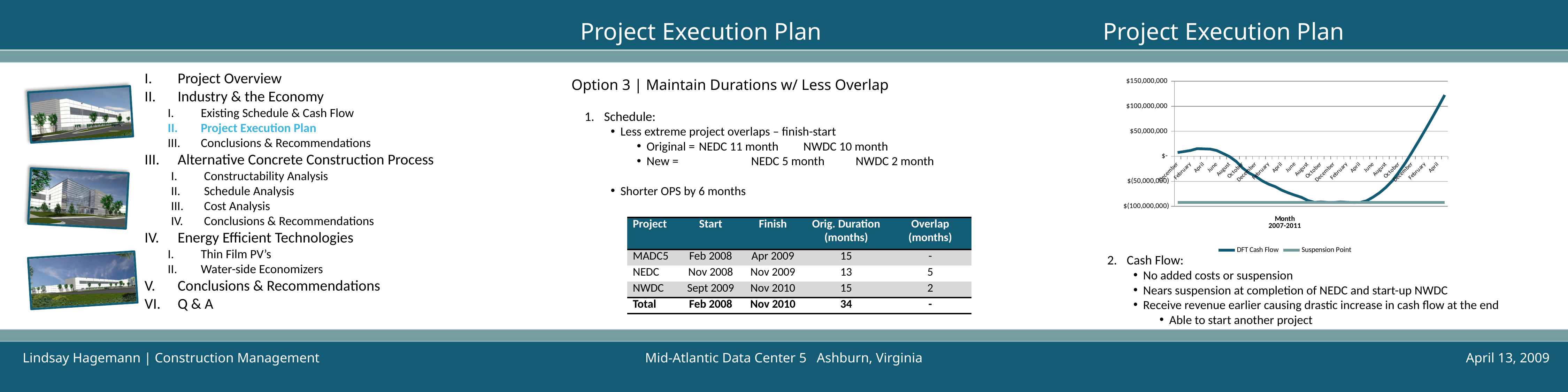
Is the Suspension Point line greater or less than $(50,000,000)? less What is the title of the chart's x axis? Month 2007-2011 Is the DFT Cash Flow value at the first December point greater or less than $50,000,000? less Does the DFT Cash Flow line end higher or lower than where it starts? higher How many series does the chart's legend list? 2 At the final April point, is the DFT Cash Flow line above or below the Suspension Point line? above Over the last several months on the x axis, does the DFT Cash Flow line rise or fall? rise What kind of chart is shown on the slide? line chart What are the two series named in the chart's legend? DFT Cash Flow and Suspension Point